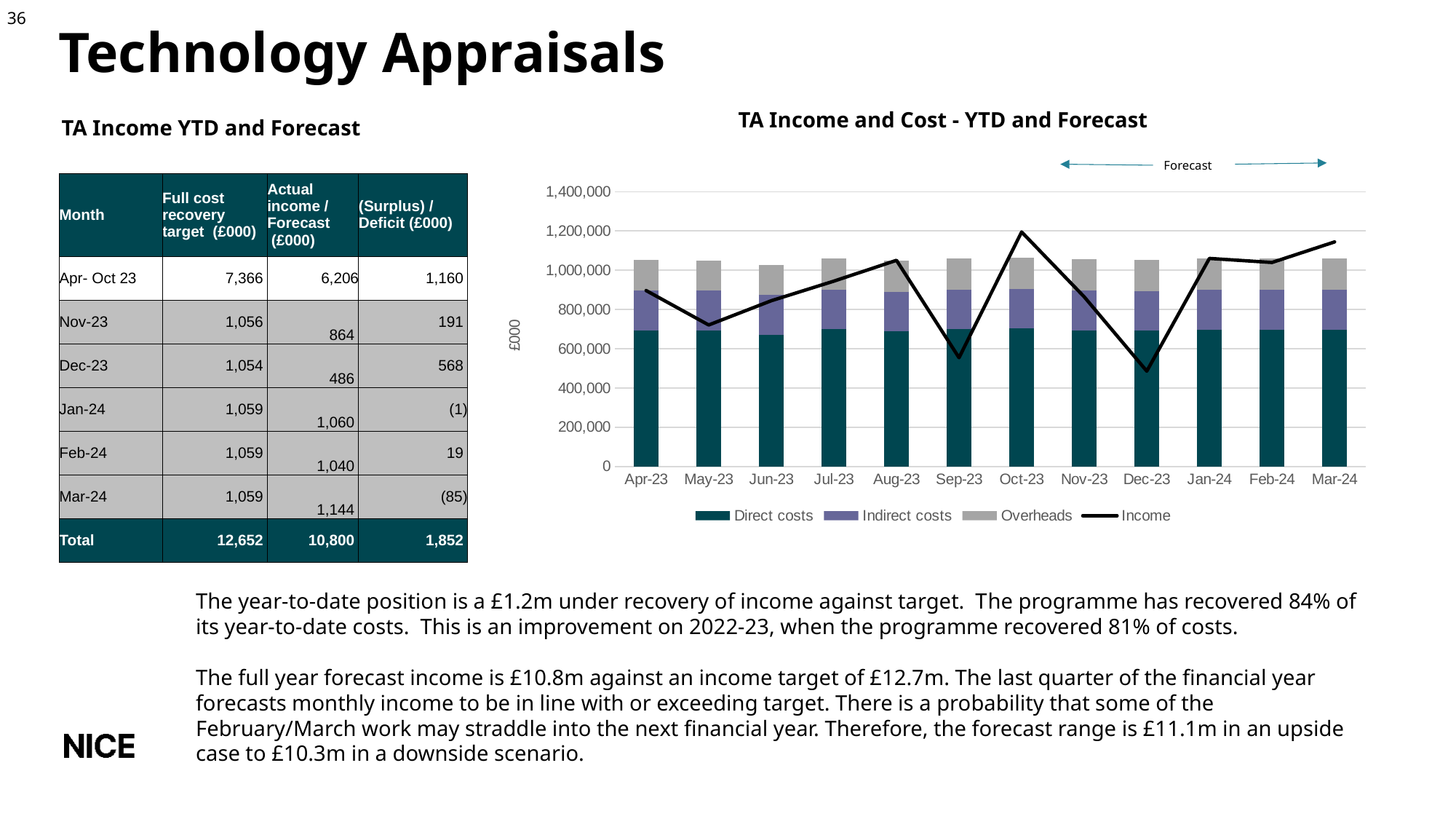
How many months are shown on the x axis of the TA Income and Cost chart? 12 In the TA Income and Cost chart, which month has the highest Income? Oct-23 In the TA Income and Cost chart, is the Income for May-23 greater or less than 800,000? less In the TA Income and Cost chart, is the Income for Sep-23 greater or less than 600,000? less In the TA Income and Cost chart, which month has the lowest Income? Dec-23 In the TA Income and Cost chart, is the Direct costs value for Apr-23 greater or less than 600,000? greater What is the title of the chart on the right of the slide? TA Income and Cost - YTD and Forecast In the TA Income and Cost chart, does the Income line rise or fall from Dec-23 to Mar-24? rise What kind of chart is the TA Income and Cost - YTD and Forecast chart? Stacked bar chart with a line In the TA Income and Cost chart, is the Income for Oct-23 larger or smaller than the Income for Sep-23? larger How many series does the legend of the TA Income and Cost chart list? 4